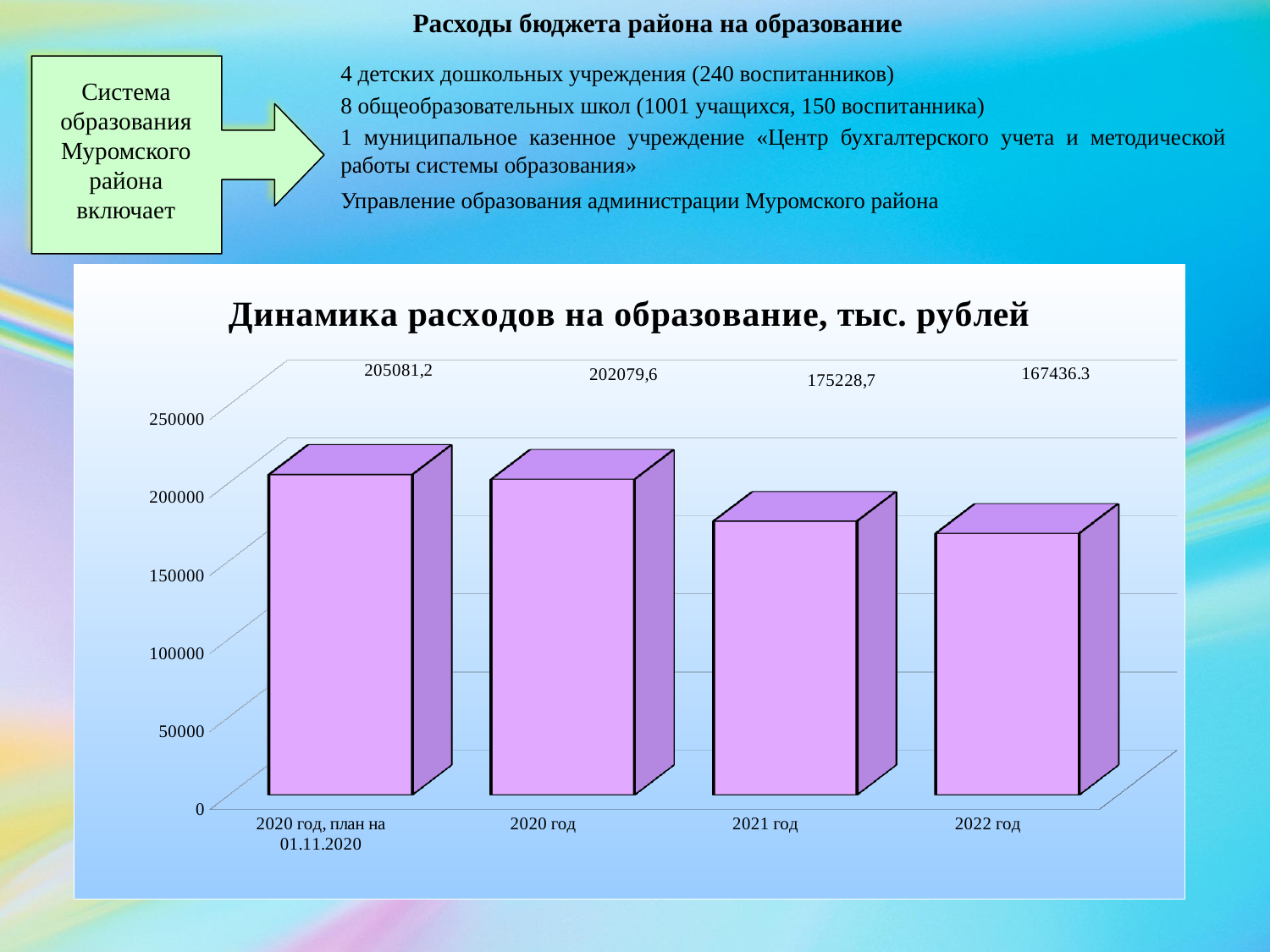
What is the value for 2021 год in the chart 'Динамика расходов на образование, тыс. рублей'? 175228,7 Which category has the lowest value in the chart 'Динамика расходов на образование, тыс. рублей'? 2022 год What kind of chart is 'Динамика расходов на образование, тыс. рублей'? bar chart Which is larger in the chart: the value for 2020 год or the value for 2021 год? 2020 год What is the difference between the values for 2021 год and 2022 год in the chart? 7792,4 What is the difference between the values for 2020 год and 2021 год in the chart? 26850,9 What is the value for '2020 год, план на 01.11.2020' in the chart? 205081,2 Is the value for 2022 год greater or less than 200000? less Do the values in the chart rise or fall from left to right along the x axis? fall What is the value for 2022 год in the chart 'Динамика расходов на образование, тыс. рублей'? 167436.3 Which category has the highest value in the chart 'Динамика расходов на образование, тыс. рублей'? 2020 год, план на 01.11.2020 How many categories are shown in the chart 'Динамика расходов на образование, тыс. рублей'? 4